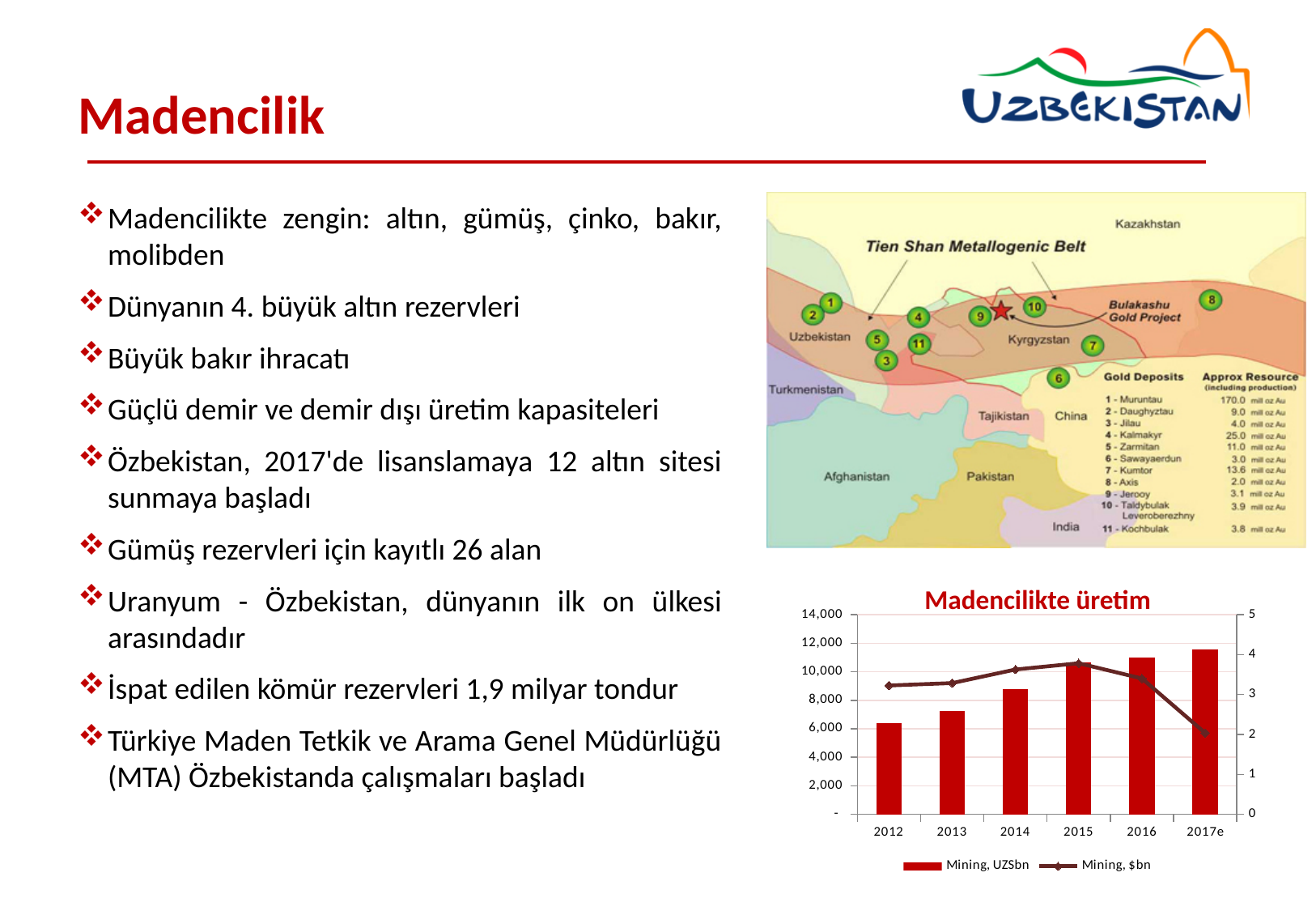
What is the title of the chart on the slide? Madencilikte üretim In the 'Madencilikte üretim' chart, is the Mining, $bn value for 2017e greater or less than 3? less What kind of chart is 'Madencilikte üretim'? bar and line chart In the 'Madencilikte üretim' chart, do the Mining, UZSbn bars rise or fall from 2012 to 2017e? rise In the 'Madencilikte üretim' chart, how many series does the legend list? 2 In the 'Madencilikte üretim' chart, is the Mining, UZSbn value for 2012 greater or less than 8,000? less In the 'Madencilikte üretim' chart, which year has the lowest Mining, UZSbn bar? 2012 In the 'Madencilikte üretim' chart, which year has the lowest Mining, $bn value? 2017e In the 'Madencilikte üretim' chart, which is larger, the Mining, UZSbn bar for 2016 or for 2013? 2016 In the 'Madencilikte üretim' chart, how many years are shown on the x axis? 6 In the 'Madencilikte üretim' chart, is the Mining, UZSbn value for 2017e greater or less than 10,000? greater In the 'Madencilikte üretim' chart, which year has the highest Mining, UZSbn bar? 2017e